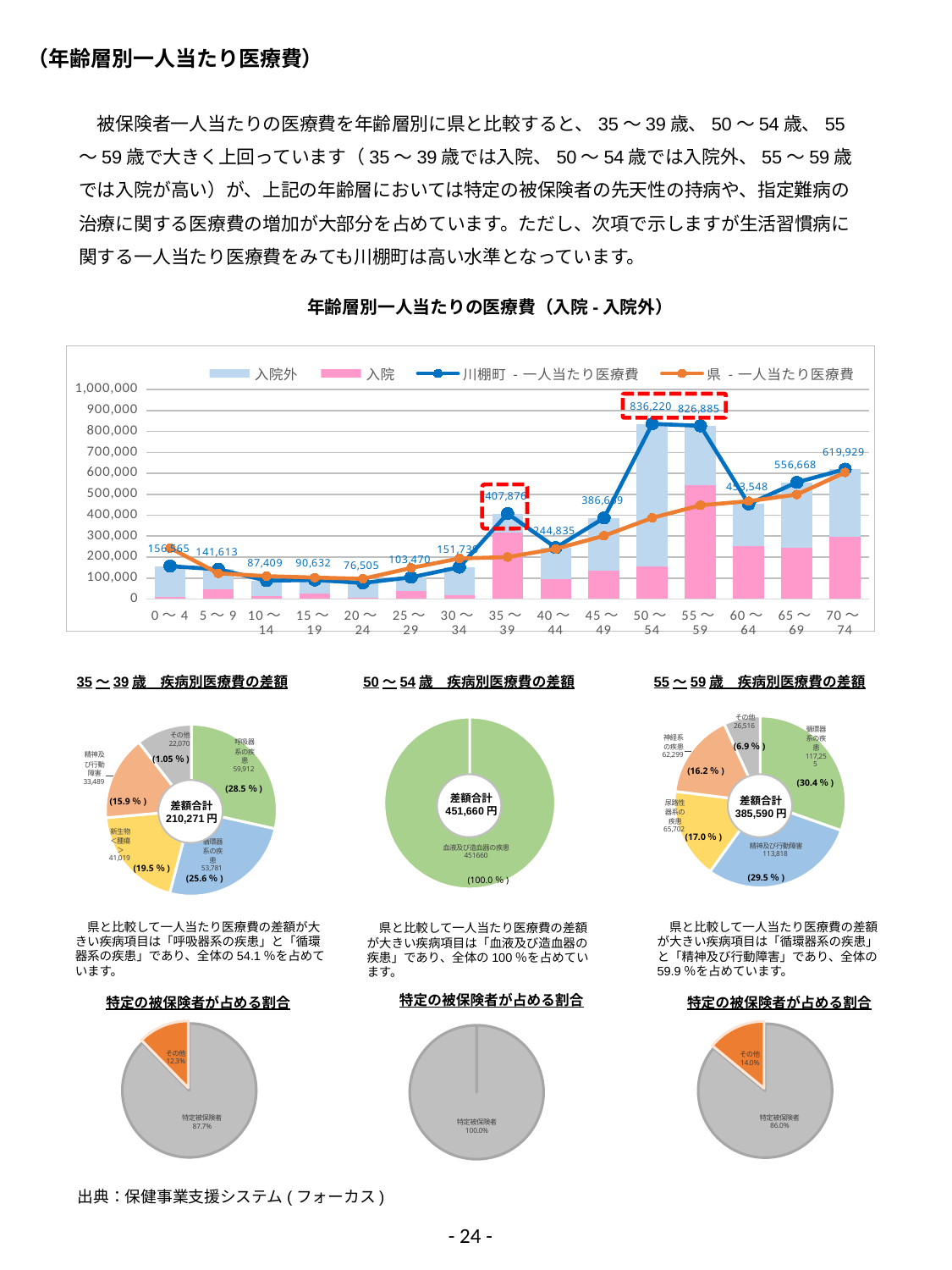
In the chart titled 年齢層別一人当たりの医療費（入院 - 入院外）, what is the 川棚町 一人当たり医療費 value for the 50～54 age group? 836,220 In the donut chart titled 55～59歳 疾病別医療費の差額, what share does 精神及び行動障害 account for? 29.5% In the chart titled 年齢層別一人当たりの医療費（入院 - 入院外）, which is larger, the 川棚町 value for 65～69 or for 70～74? 70～74 In the chart titled 年齢層別一人当たりの医療費（入院 - 入院外）, how many age-group categories are shown on the x axis? 15 In the chart titled 年齢層別一人当たりの医療費（入院 - 入院外）, which age group has the lowest 川棚町 一人当たり医療費? 20～24 In the pie chart titled 特定の被保険者が占める割合 on the left (35～39歳), what percentage is 特定被保険者? 87.7% In the chart titled 年齢層別一人当たりの医療費（入院 - 入院外）, how many series does the legend list? 4 In the chart titled 年齢層別一人当たりの医療費（入院 - 入院外）, which age group has the highest 川棚町 一人当たり医療費? 50～54 In the chart titled 年齢層別一人当たりの医療費（入院 - 入院外）, what is the 川棚町 一人当たり医療費 value for the 35～39 age group? 407,876 In the chart titled 年齢層別一人当たりの医療費（入院 - 入院外）, is the 川棚町 value for 70～74 greater or less than 600,000? greater In the chart titled 年齢層別一人当たりの医療費（入院 - 入院外）, what is the difference between the 川棚町 values for 50～54 and 55～59? 9,335 In the donut chart titled 35～39歳 疾病別医療費の差額, what is the 差額合計? 210,271円